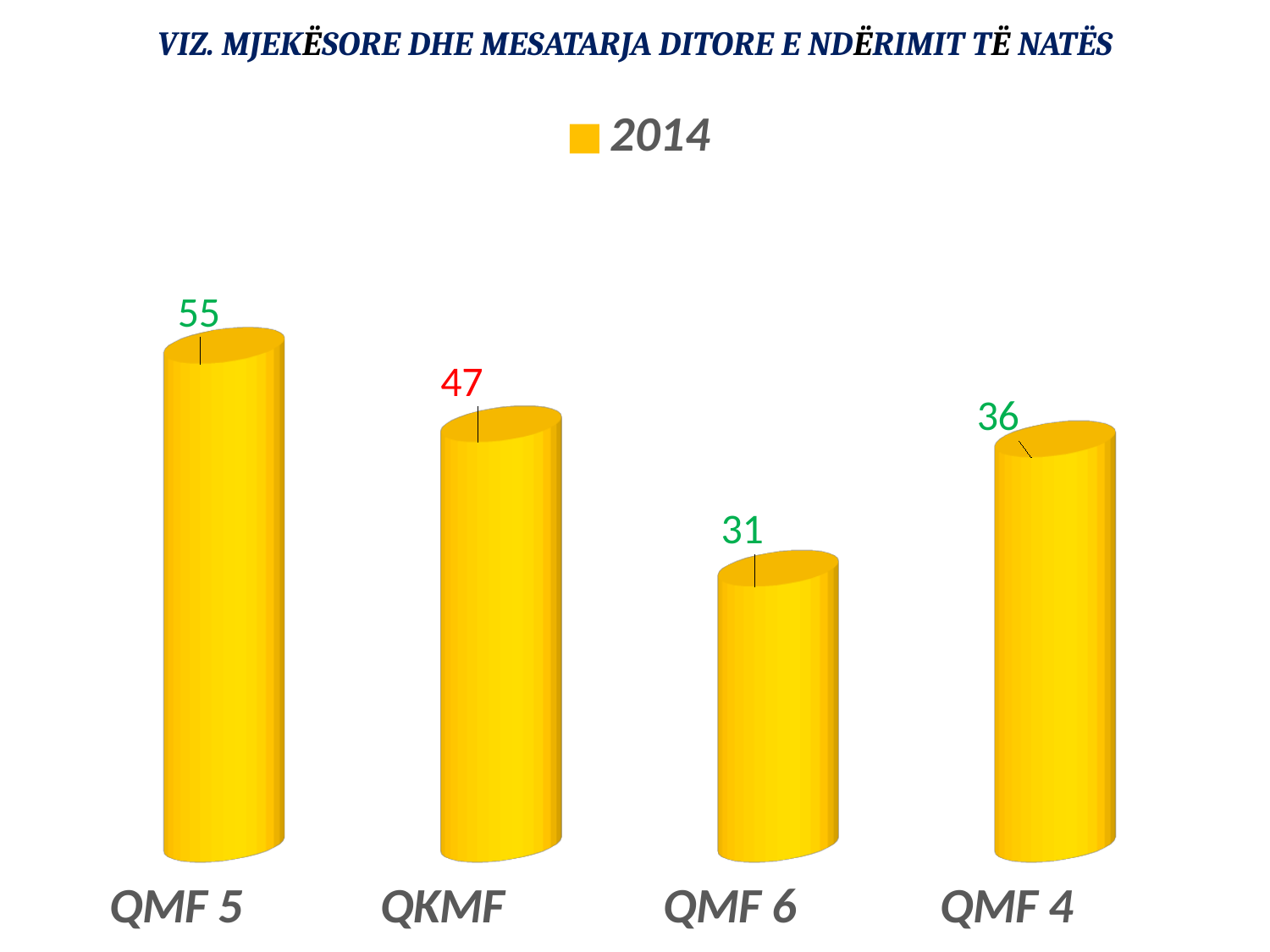
Which category has the highest value? QMF 5 What is the value for QKMF? 47 Which is larger, the value for QKMF or the value for QMF 4? QKMF How many categories are shown in the chart? 4 What is the value for QMF 5? 55 What is the value for QMF 4? 36 What is the value for QMF 6? 31 What is the difference between the values for QMF 4 and QMF 6? 5 How many series does the legend list? 1 Which category has the lowest value? QMF 6 What kind of chart is shown on the slide? Bar chart What is the difference between the values for QMF 5 and QKMF? 8